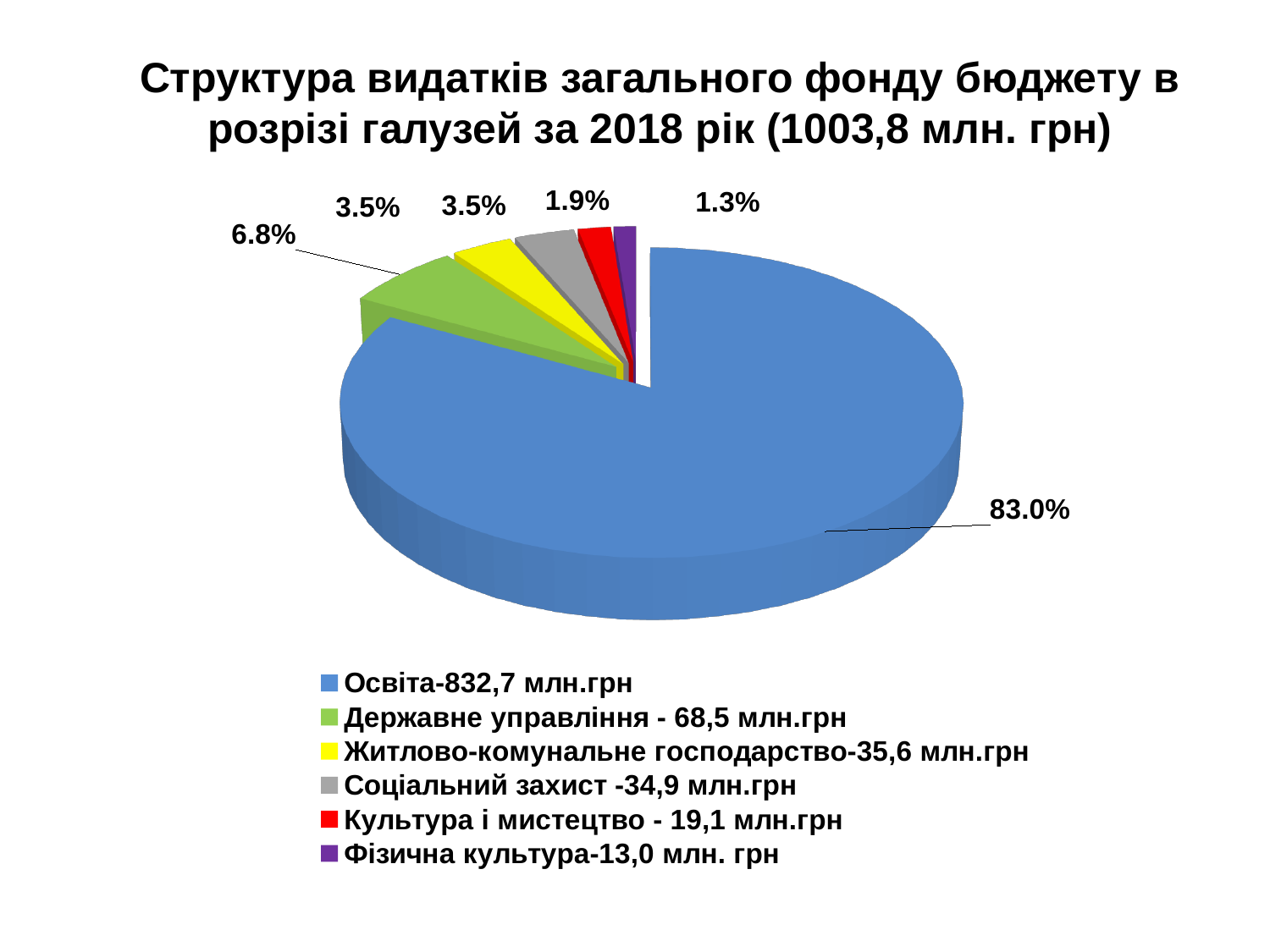
What kind of chart is shown on the slide? Pie chart What is the difference in percentage points between the Освіта slice and the Державне управління slice? 76.2 What percentage is shown for Соціальний захист? 3.5% How many entries does the legend list? 6 What percentage is shown for Культура і мистецтво? 1.9% Which category has the smallest slice of the pie? Фізична культура What share of the pie does Освіта (education) take? 83.0% Which is larger, the slice for Культура і мистецтво or the slice for Фізична культура? Культура і мистецтво What share of the pie does Державне управління take? 6.8% How many slices does the pie chart have? 6 Which category has the largest slice of the pie? Освіта What colour is the slice for Житлово-комунальне господарство? Yellow